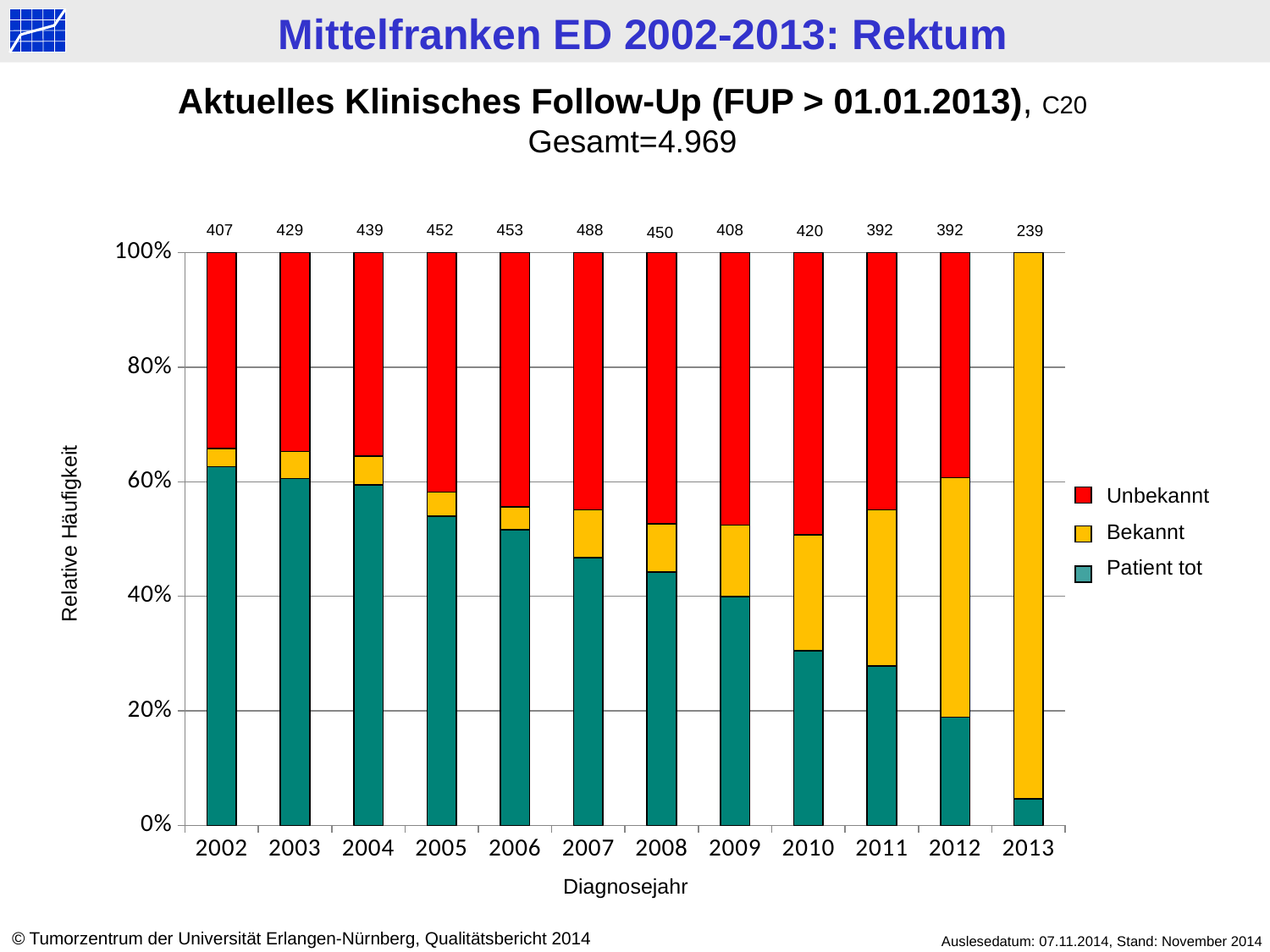
Which has the larger number printed above its bar, 2005 or 2011? 2005 What kind of chart is shown on the slide? stacked bar chart Which diagnosis year has the lowest number printed above its bar? 2013 What number is printed above the bar for 2013? 239 What number is printed above the bar for 2007? 488 How many series does the legend list? 3 Is the share of 'Patient tot' in 2010 greater or less than 40%? less Which diagnosis year has the highest number printed above its bar? 2007 What number is printed above the bar for 2002? 407 How many diagnosis years are shown on the x axis? 12 What is the difference between the numbers printed above the bars for 2007 and 2013? 249 Does the share of 'Patient tot' rise or fall from 2002 to 2013? fall